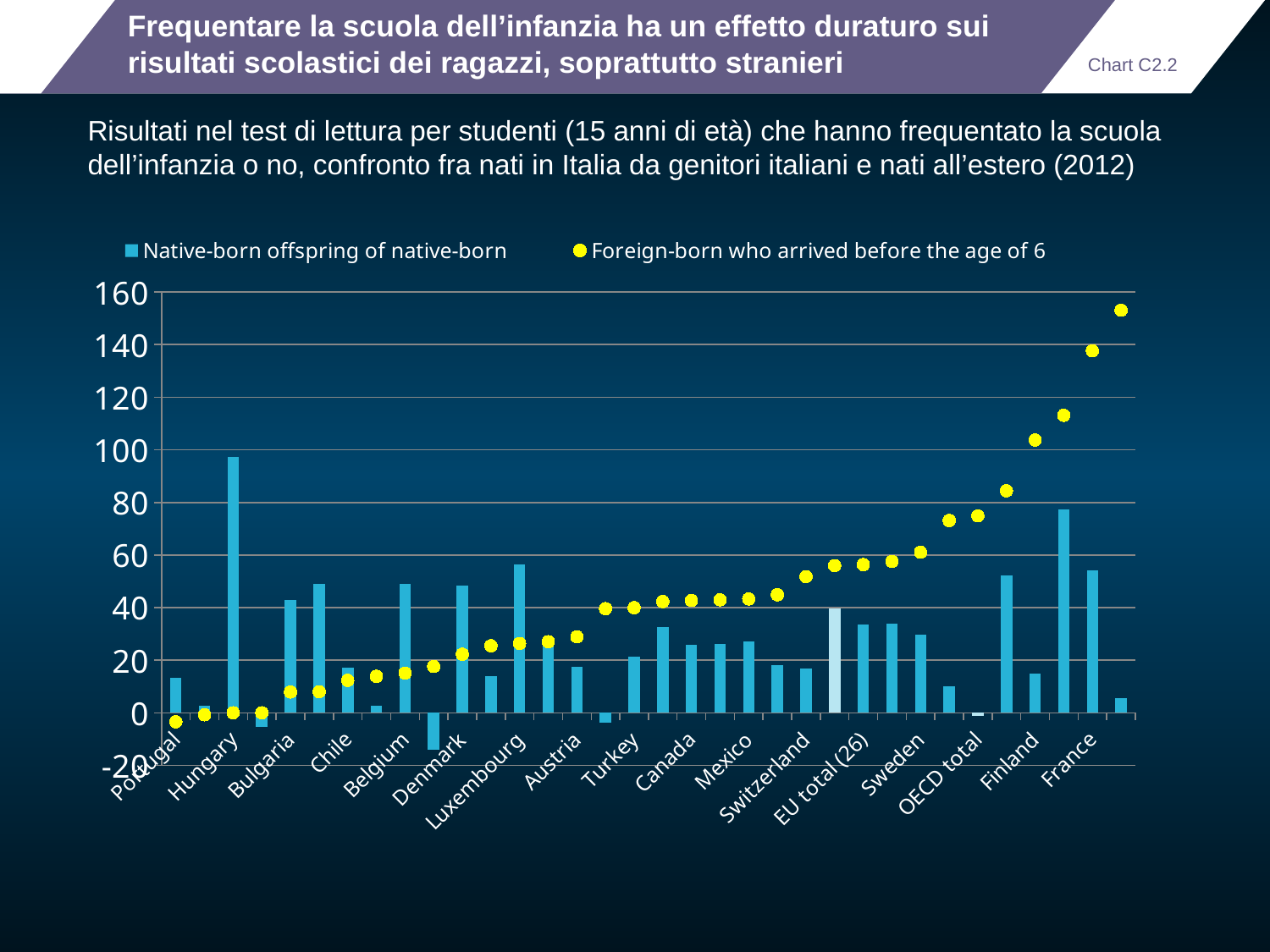
Is the 'Native-born offspring of native-born' value for Hungary greater or less than 80? greater Is the 'Foreign-born who arrived before the age of 6' value for Switzerland greater or less than 40? greater What kind of chart is used for the 'Native-born offspring of native-born' series? bar chart Which country has the highest 'Native-born offspring of native-born' bar? Hungary What colour are the markers for the 'Foreign-born who arrived before the age of 6' series? yellow Which is larger, the 'Native-born offspring of native-born' value for Hungary or for France? Hungary Is the 'Native-born offspring of native-born' value for Finland greater or less than 20? less How many series does the legend list? 2 Which is larger, the 'Foreign-born who arrived before the age of 6' value for France or for Portugal? France Do the values for 'Foreign-born who arrived before the age of 6' rise or fall from left to right along the x axis? rise